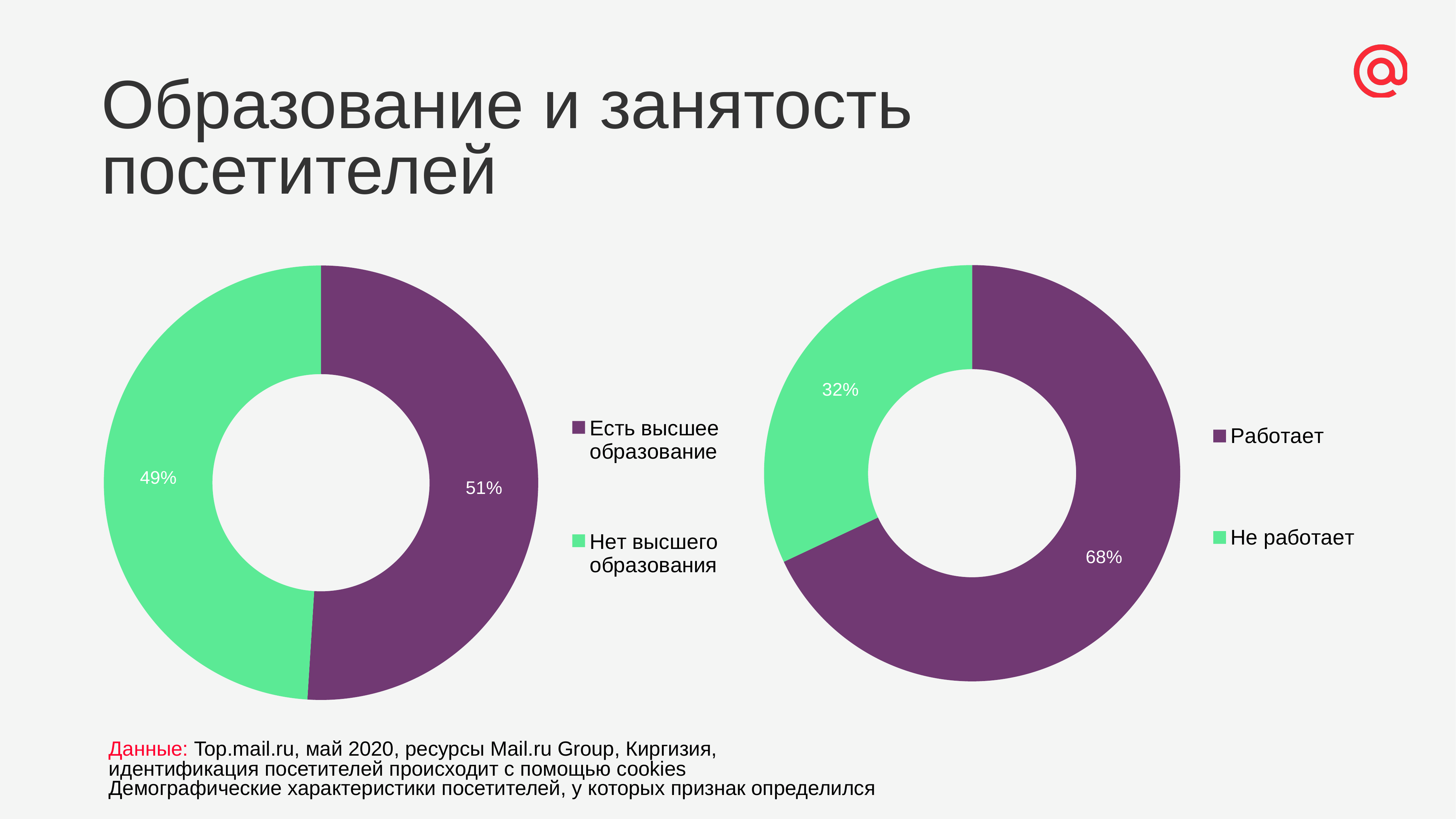
In the right chart, what is the difference in percentage points between Работает and Не работает? 36 In the left chart, what is the difference in percentage points between Есть высшее образование and Нет высшего образования? 2 How many categories does the legend of the right chart list? 2 In the left chart, what share of visitors have higher education (Есть высшее образование)? 51% In the right chart, what share of visitors are not working (Не работает)? 32% In the right chart, which is larger: Работает or Не работает? Работает In the right chart, which category has the largest share? Работает What colour represents Нет высшего образования in the left chart? Green What type of chart is used on the left side of the slide? Pie (doughnut) chart In the right chart, what share of visitors are working (Работает)? 68% In the right chart, which category has the smallest share? Не работает In the left chart, what share of visitors do not have higher education (Нет высшего образования)? 49%